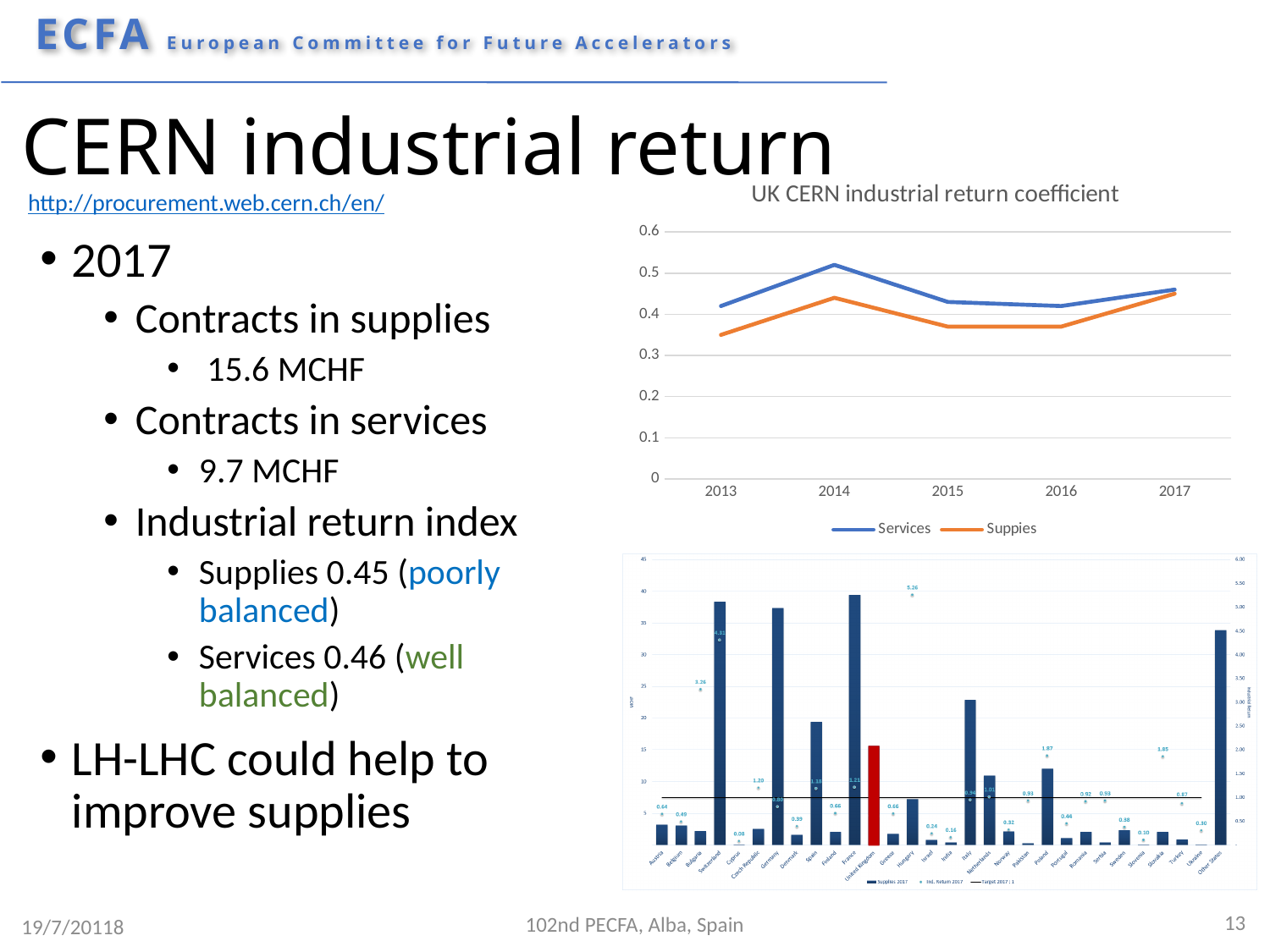
In the 'UK CERN industrial return coefficient' chart, is the Services value for 2014 greater or less than 0.5? greater In the 'UK CERN industrial return coefficient' chart, does the Services line rise or fall from 2014 to 2016? fall What kind of chart is the chart at the bottom right of the slide showing countries along the x axis? bar chart In the 'UK CERN industrial return coefficient' chart, is the Services value for 2015 greater or less than 0.4? greater How many series does the legend of the 'UK CERN industrial return coefficient' chart list? 2 In the 'UK CERN industrial return coefficient' chart, which series has the larger value in 2014, Services or Supplies? Services How many years are plotted on the x axis of the 'UK CERN industrial return coefficient' chart? 5 In the 'UK CERN industrial return coefficient' chart, is the Supplies value for 2015 greater or less than 0.4? less In the 'UK CERN industrial return coefficient' chart, does the Supplies line rise or fall from 2016 to 2017? rise In the 'UK CERN industrial return coefficient' chart, in which year is the Services value highest? 2014 What kind of chart is the 'UK CERN industrial return coefficient' chart? line chart